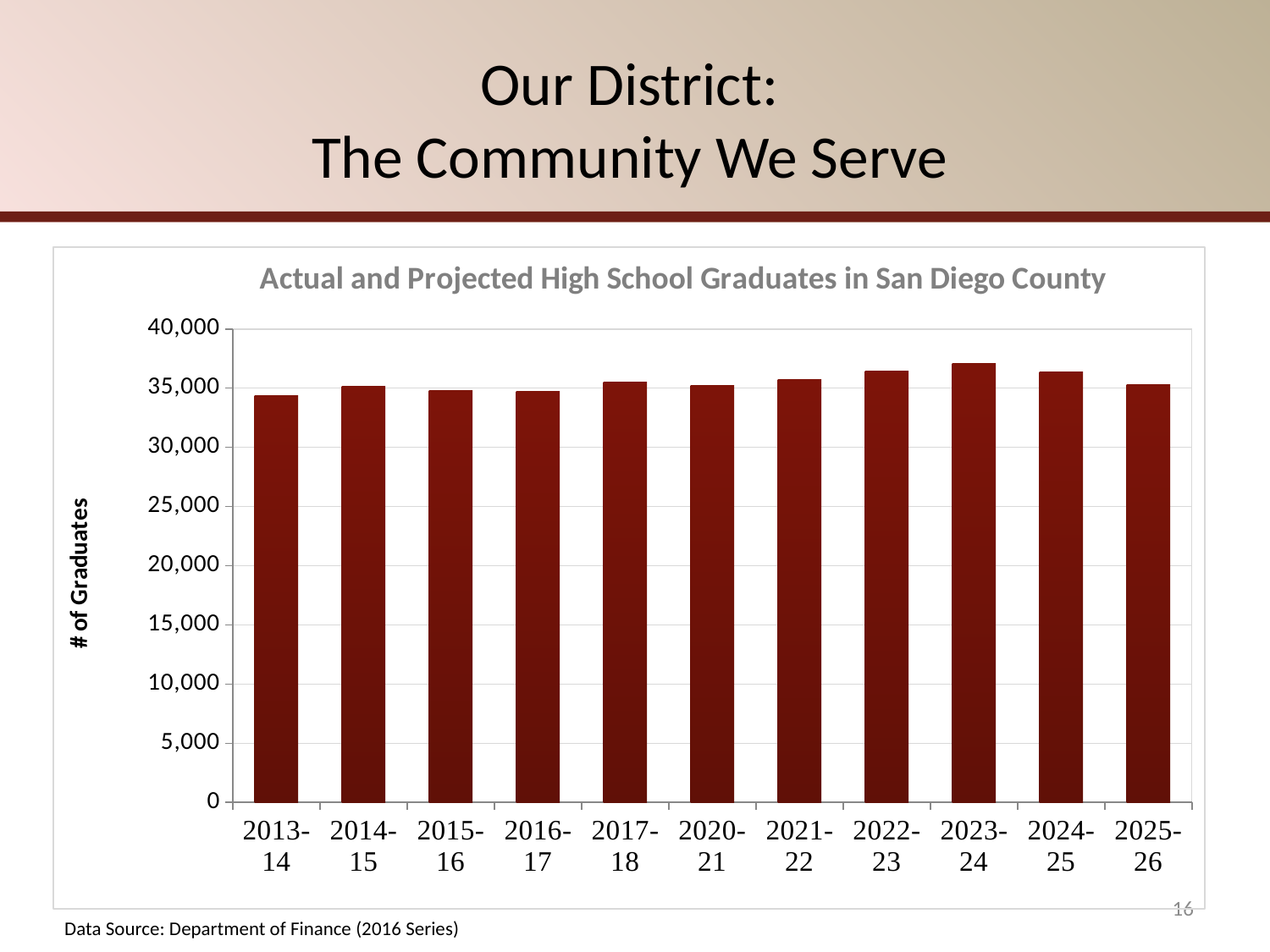
Is the value for 2013-14 greater or less than 35,000? less Is the value for 2015-16 greater or less than 30,000? greater What kind of chart is shown on the slide? bar chart How many school years are shown on the x axis of the chart? 11 Which is larger, the value for 2022-23 or the value for 2015-16? 2022-23 What is the title of the chart? Actual and Projected High School Graduates in San Diego County Is the value for 2023-24 greater or less than 35,000? greater What is the label on the vertical axis of the chart? # of Graduates Which school year has the highest number of graduates? 2023-24 Which is larger, the value for 2023-24 or the value for 2013-14? 2023-24